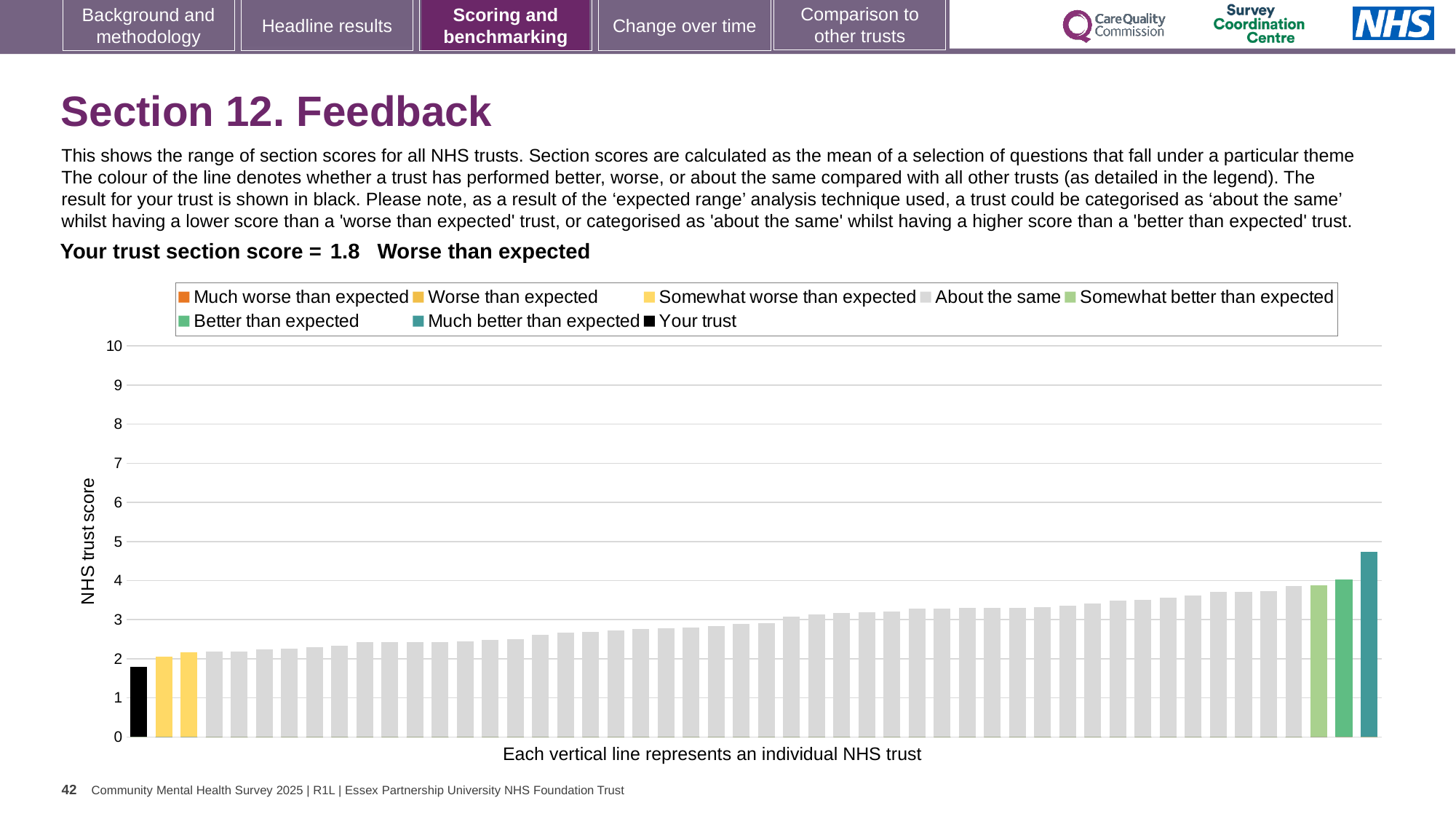
How many entries does the chart legend list? 8 What colour is used for 'Your trust' in the chart legend? black Is the value of the black 'Your trust' bar greater or less than 2? less Which bar is the lowest on the chart? Your trust Which legend category does the highest bar on the chart belong to? Much better than expected What kind of chart is shown on the slide? bar chart Do the bar values rise or fall from left to right along the x axis? rise Is the 'Your trust' bar higher or lower than the 'Much better than expected' bar? lower What is the section score for your trust shown on the slide? 1.8 How many bars are coloured as 'Somewhat worse than expected'? 2 What is the label on the y axis of the chart? NHS trust score Is the value of the tallest bar (Much better than expected) greater or less than 4? greater